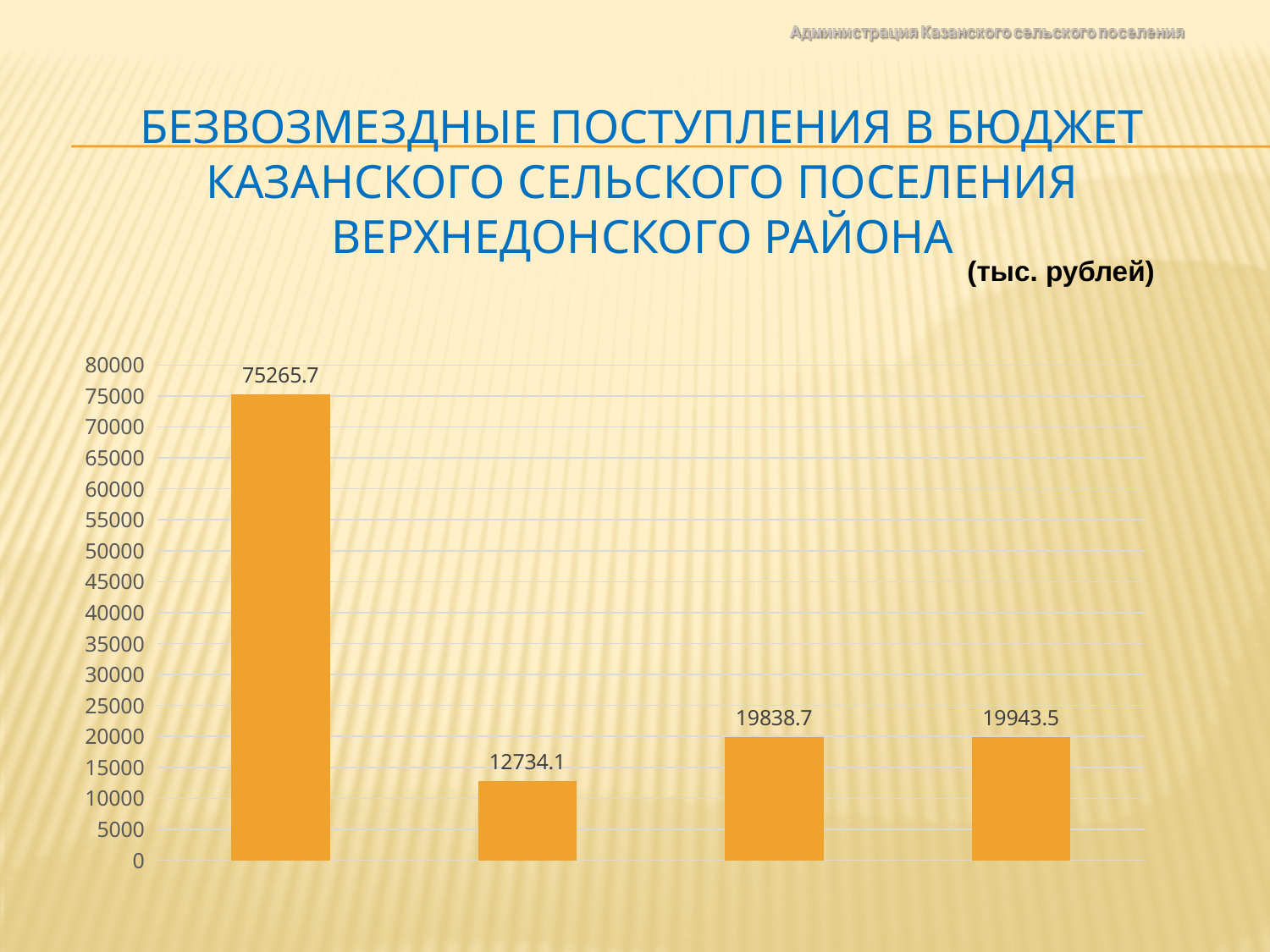
Which bar has the highest value? The first (leftmost) bar, 75265.7 What is the difference between the fourth bar (19943.5) and the third bar (19838.7)? 104.8 Which is larger, the value of the second bar or the value of the third bar? The third bar (19838.7) What is the value shown on the second bar from the left? 12734.1 Is the value of the first bar greater or less than 70000? greater What is the value shown on the third bar from the left? 19838.7 What is the value shown on the fourth (rightmost) bar? 19943.5 What unit of measurement is stated for the chart values? тыс. рублей What is the difference between the first bar (75265.7) and the second bar (12734.1)? 62531.6 How many bars are plotted in the chart? 4 What is the value shown on the first (leftmost) bar? 75265.7 Which bar has the lowest value? The second bar from the left, 12734.1